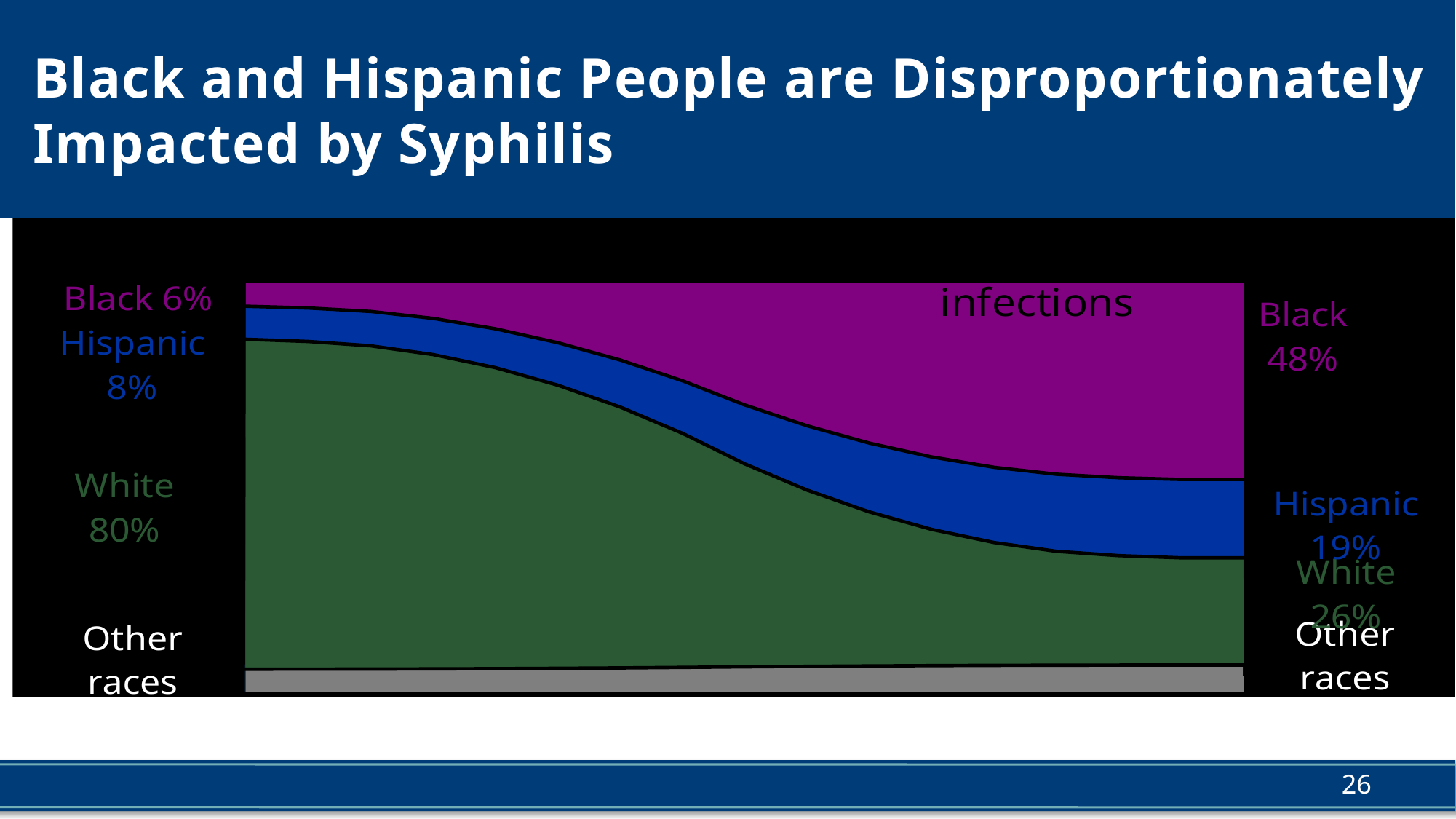
What colour is used for the Hispanic band in the chart? Blue What percentage is shown for Hispanic on the right side of the chart (infections)? 19% By how many percentage points does the Black share increase from the left side to the right side of the chart? 42 percentage points Which group has the largest share on the left side of the chart? White Which group has the largest share on the right side of the chart (infections)? Black What percentage is shown for White on the left side of the chart? 80% What percentage is shown for Black on the left side of the chart? 6% How many racial/ethnic groups are shown in the chart? 4 What percentage is shown for White on the right side of the chart (infections)? 26% What percentage is shown for Black on the right side of the chart (infections)? 48% What percentage is shown for Hispanic on the left side of the chart? 8% On the right side of the chart, which is larger: the White share or the Hispanic share? White